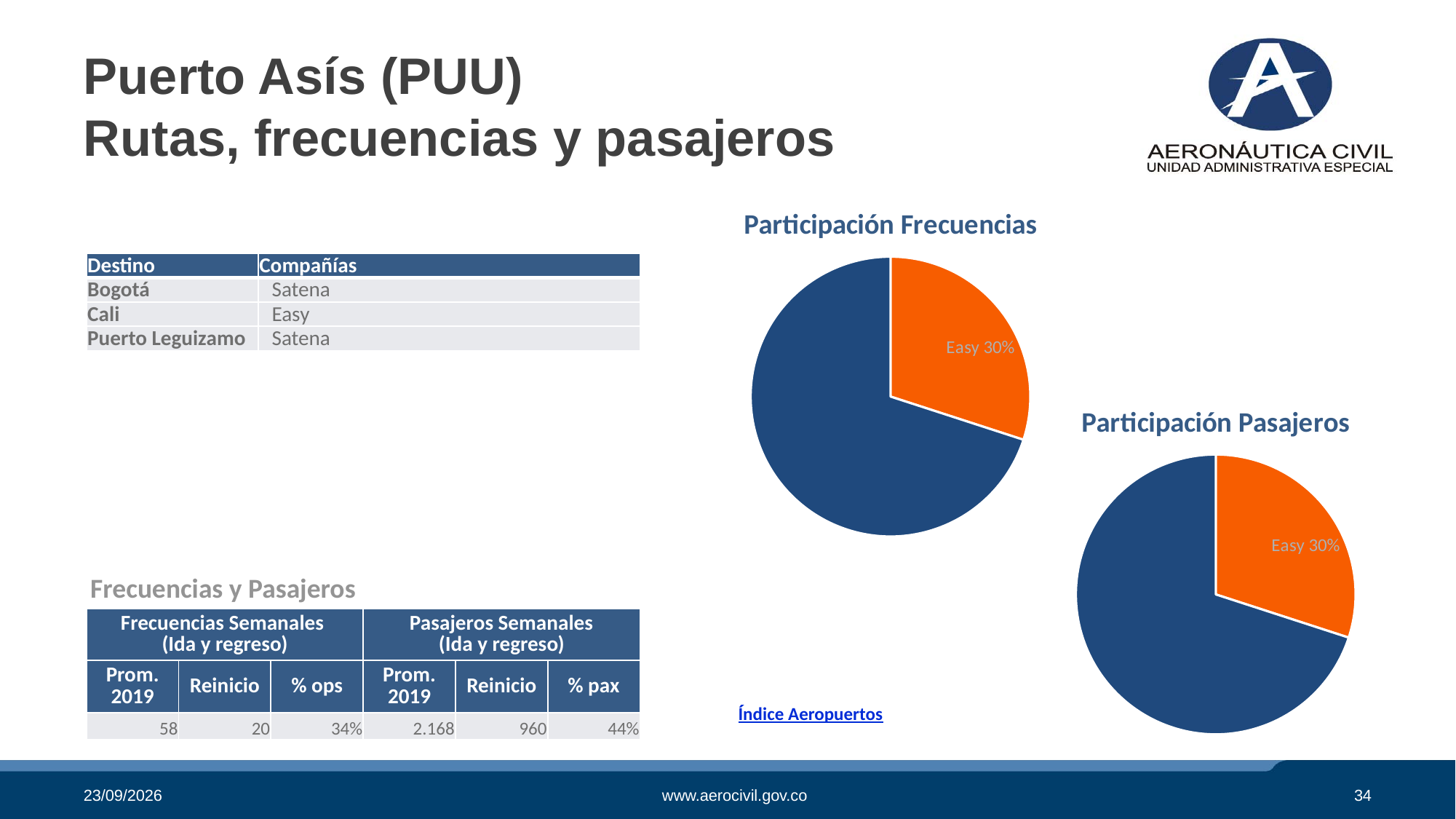
How many slices does the "Participación Frecuencias" pie chart have? 2 What kind of chart is the "Participación Frecuencias" chart? pie chart In the "Participación Frecuencias" chart, which slice is smaller, the orange Easy slice or the blue slice? the orange Easy slice What kind of chart is the "Participación Pasajeros" chart? pie chart Is Easy's share the same in the "Participación Frecuencias" chart and the "Participación Pasajeros" chart? yes In the "Participación Pasajeros" chart, what share of the pie does Easy have? 30% In the "Participación Pasajeros" chart, which slice is larger, the orange Easy slice or the blue slice? the blue slice In the "Participación Pasajeros" chart, is the share for Easy greater or less than 50%? less In the "Participación Frecuencias" chart, what share of the pie does Easy have? 30% In the "Participación Frecuencias" chart, is the share for Easy greater or less than 50%? less What colour is the Easy slice in the "Participación Frecuencias" chart? orange How many slices does the "Participación Pasajeros" pie chart have? 2